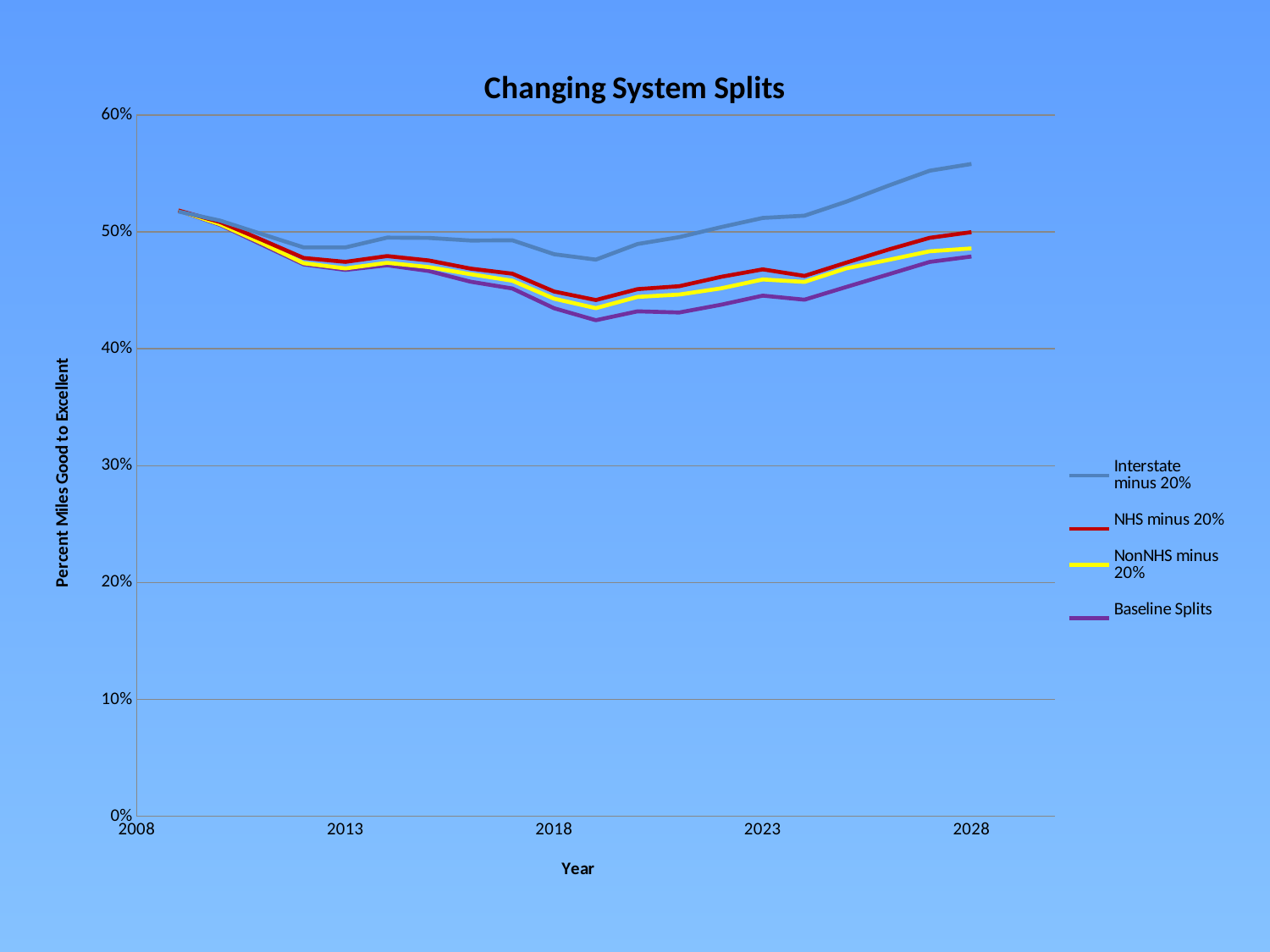
Is the lowest point of the Baseline Splits line (around 2019) greater or less than 40%? greater How many series does the legend list? 4 Does the Interstate minus 20% line rise or fall between 2019 and 2028? rise What is the title of the chart? Changing System Splits What kind of chart is shown on the slide? line chart Is the value for Interstate minus 20% in 2028 greater or less than 50%? greater Which series has the highest value in 2028? Interstate minus 20% What is the label on the vertical axis? Percent Miles Good to Excellent Which is larger in 2023, Interstate minus 20% or Baseline Splits? Interstate minus 20% Does the NHS minus 20% line rise or fall between 2009 and 2019? fall Which series has the lowest value in 2028? Baseline Splits Is the value for Baseline Splits in 2028 greater or less than 50%? less